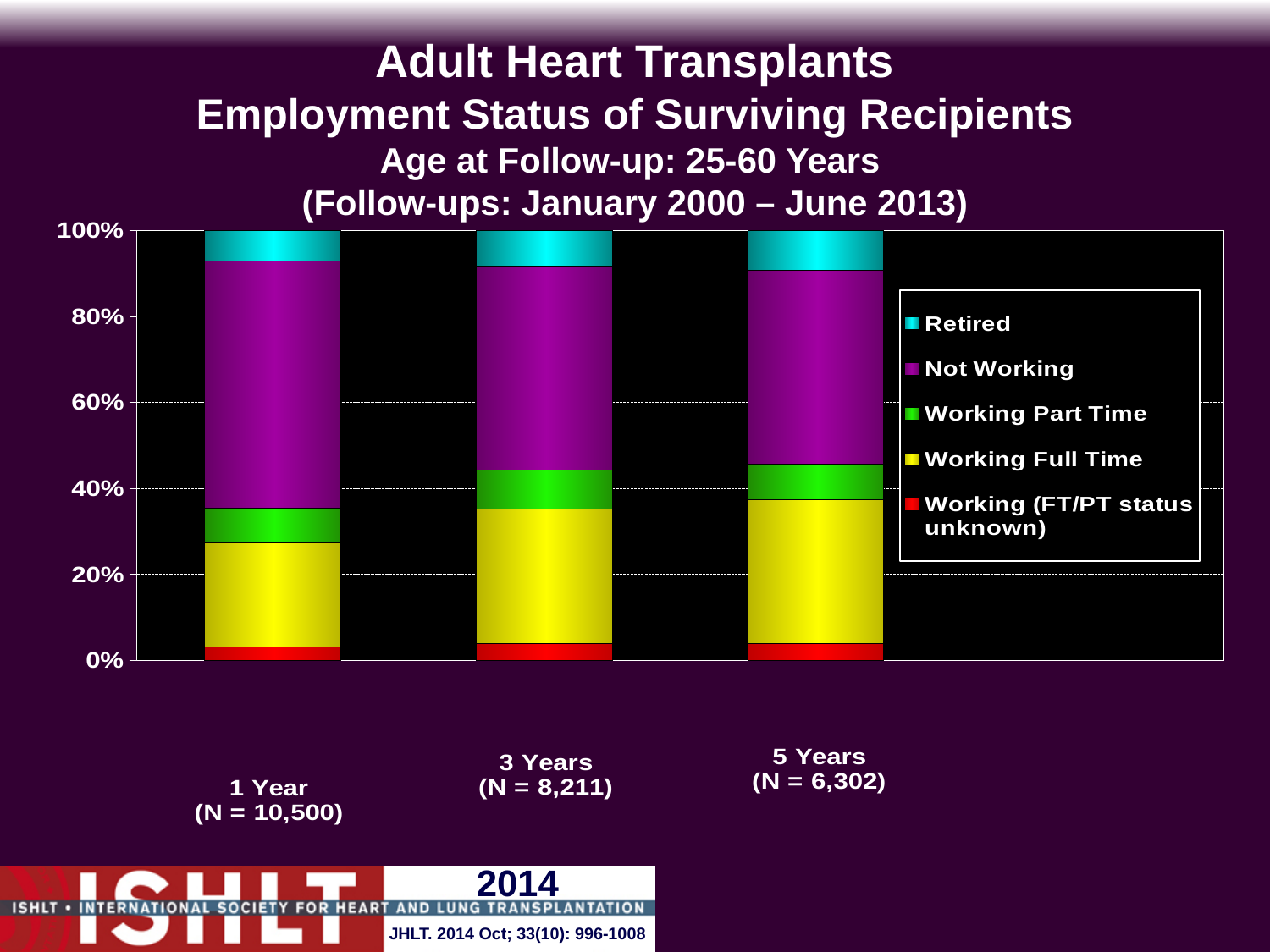
In the 5 Years bar, which segment is the smallest? Working (FT/PT status unknown) In the 1 Year bar, which is larger: the Not Working segment or the Working Full Time segment? Not Working What is the N shown for the 1 Year follow-up category? N = 10,500 What kind of chart is shown on the slide? Stacked bar chart Does the share of Not Working recipients rise or fall from 1 Year to 5 Years? fall Is the cumulative top of the Working Part Time segment in the 1 Year bar greater or less than 40%? less How many series does the legend list? 5 How many follow-up time points (bars) are plotted in the chart? 3 In the 3 Years bar, which segment is the largest? Not Working Is the cumulative top of the Working Full Time segment in the 5 Years bar greater or less than 20%? greater Which employment status series is listed first (at the top) in the legend? Retired Is the cumulative top of the Not Working segment in the 1 Year bar greater or less than 80%? greater